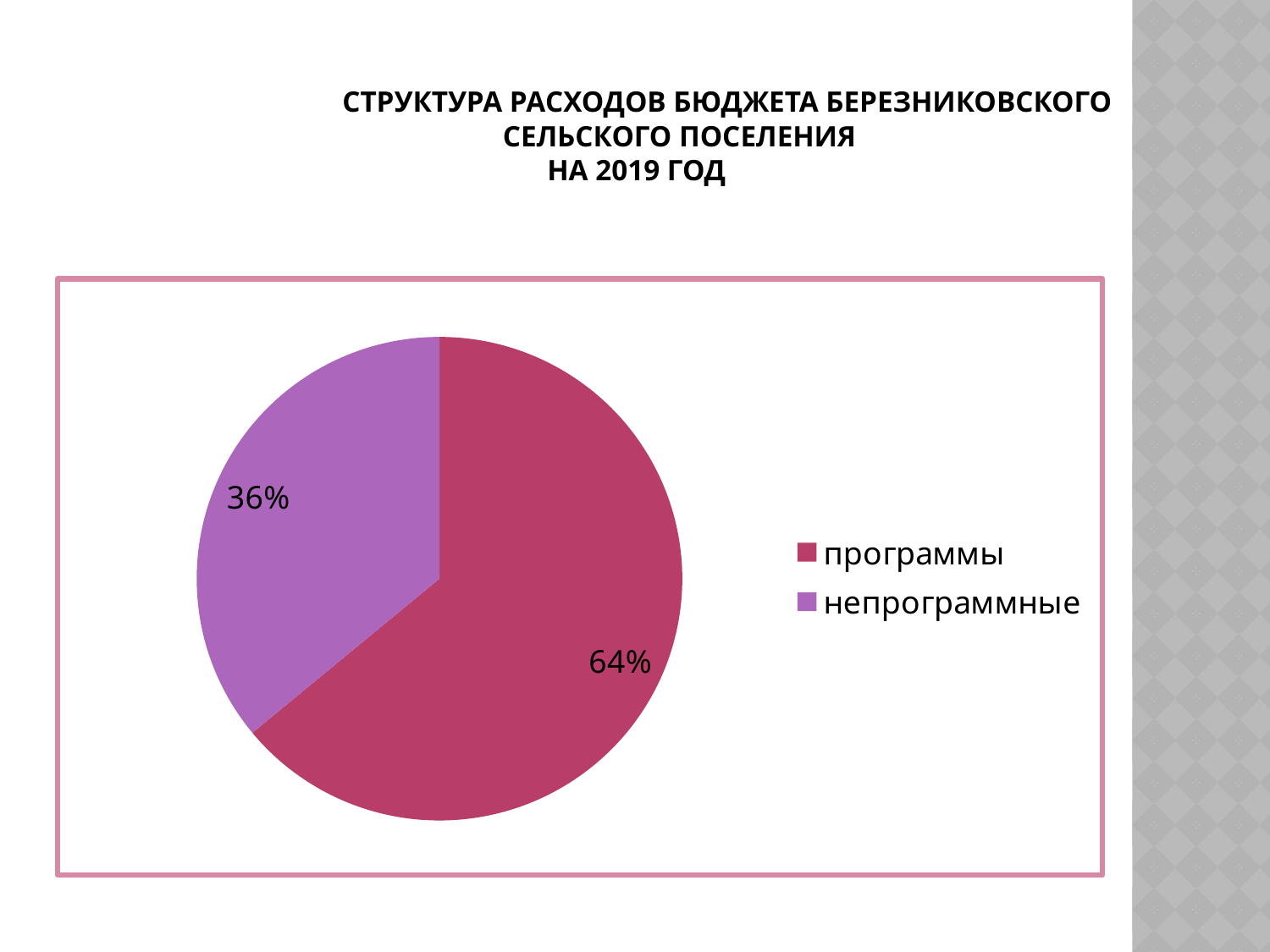
Which is larger: the "программы" slice or the "непрограммные" slice? программы What is the difference in percentage points between the "программы" and "непрограммные" slices? 28 How many categories are shown in the pie chart? 2 What share of the pie does the "программы" slice represent? 64% Which category has the largest slice of the pie? программы What share of the pie does the "непрограммные" slice represent? 36% What is the total of the two slices shown in the pie chart? 100% Which year does the chart title say the budget expenditure structure refers to? 2019 What colour is the "непрограммные" slice? purple Which category has the smallest slice of the pie? непрограммные What kind of chart is shown on the slide? pie chart